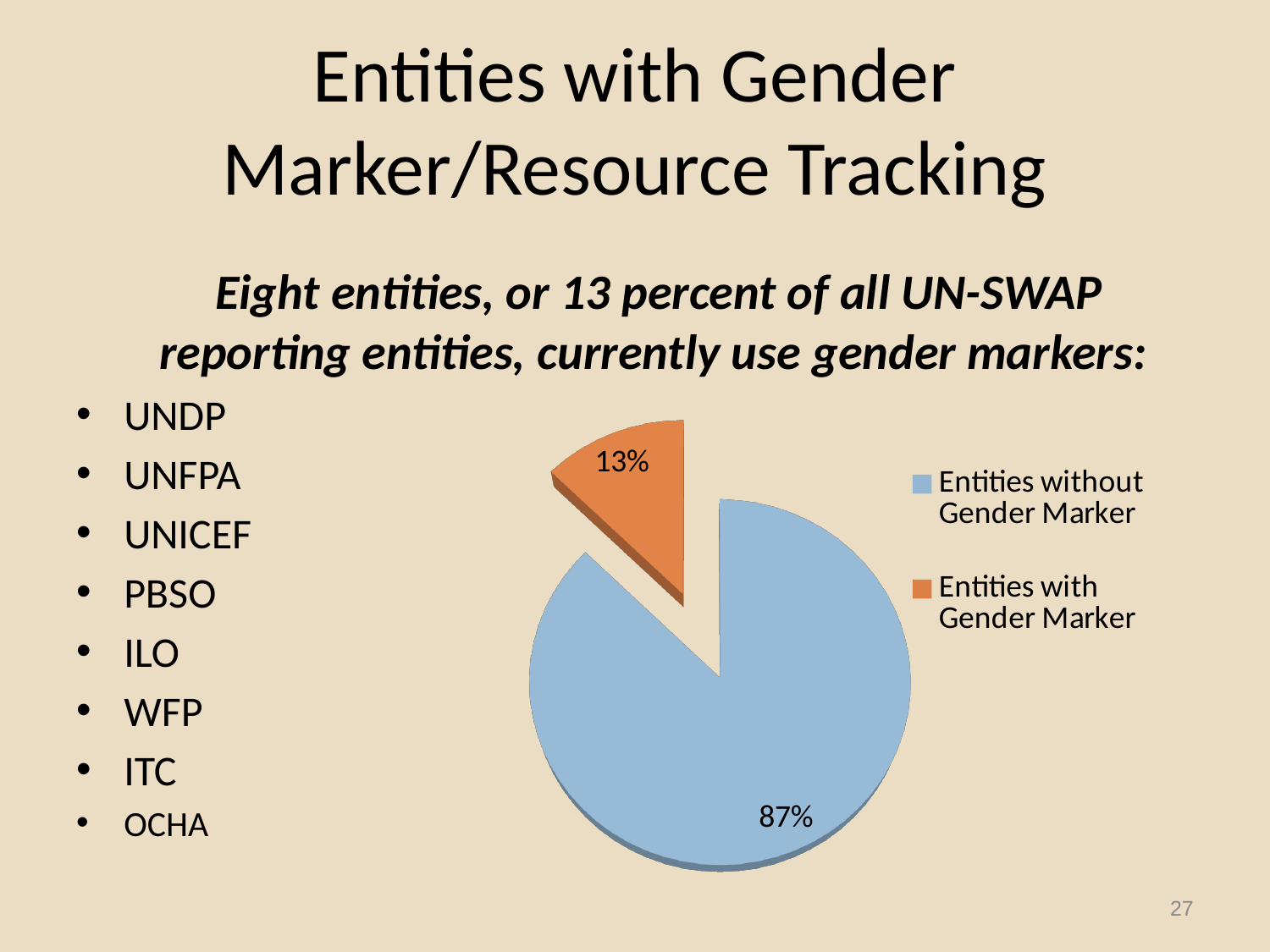
What is the difference in percentage points between the Entities without Gender Marker slice and the Entities with Gender Marker slice? 74 Which is larger: the share for Entities with Gender Marker or the share for Entities without Gender Marker? Entities without Gender Marker Which slice of the pie is the smallest? Entities with Gender Marker What percentage of the pie is labelled for Entities with Gender Marker? 13% What colour is the Entities with Gender Marker slice in the pie chart? orange How many entries does the legend of the pie chart list? 2 How many slices does the pie chart have? 2 What share of the pie does the Entities with Gender Marker slice represent? 13% Which slice of the pie is the largest? Entities without Gender Marker What percentage of the pie is labelled for Entities without Gender Marker? 87% What colour is the Entities without Gender Marker slice in the pie chart? blue What kind of chart is shown on the slide? pie chart